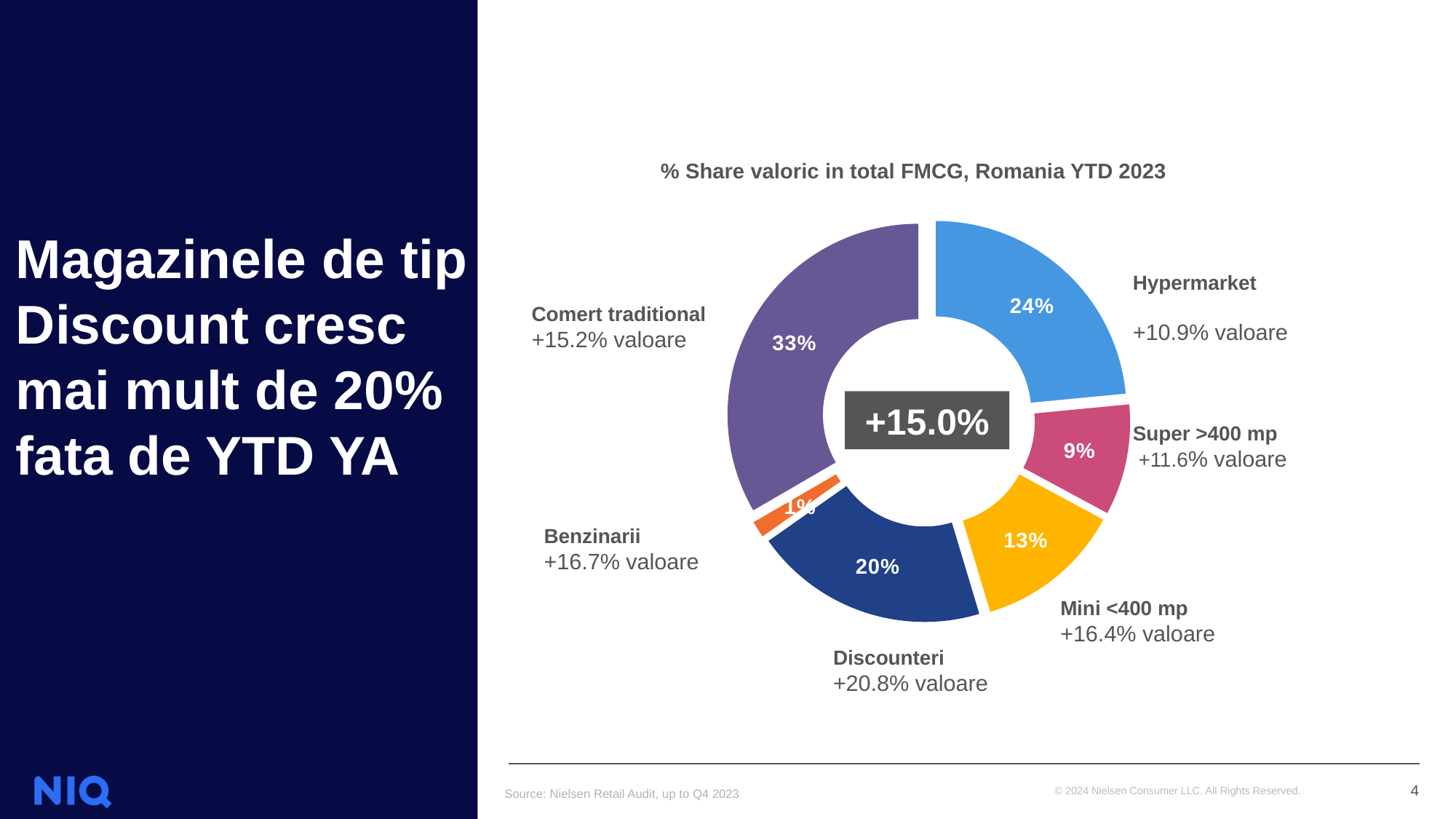
What share of total FMCG value does Comert traditional hold? 33% Which has a larger share, Discounteri or Mini <400 mp? Discounteri Which channel has the largest share of total FMCG value? Comert traditional What value growth is shown for Discounteri? +20.8% valoare What is the difference in share between Hypermarket and Super >400 mp? 15 percentage points Which channel has the smallest share of total FMCG value? Benzinarii What is the title of the chart? % Share valoric in total FMCG, Romania YTD 2023 What share of total FMCG value do Discounteri hold? 20% What share of total FMCG value does Mini <400 mp hold? 13% What kind of chart is shown on the slide? Donut (pie) chart How many channels (slices) are shown in the chart? 6 What share of total FMCG value does Hypermarket hold? 24%